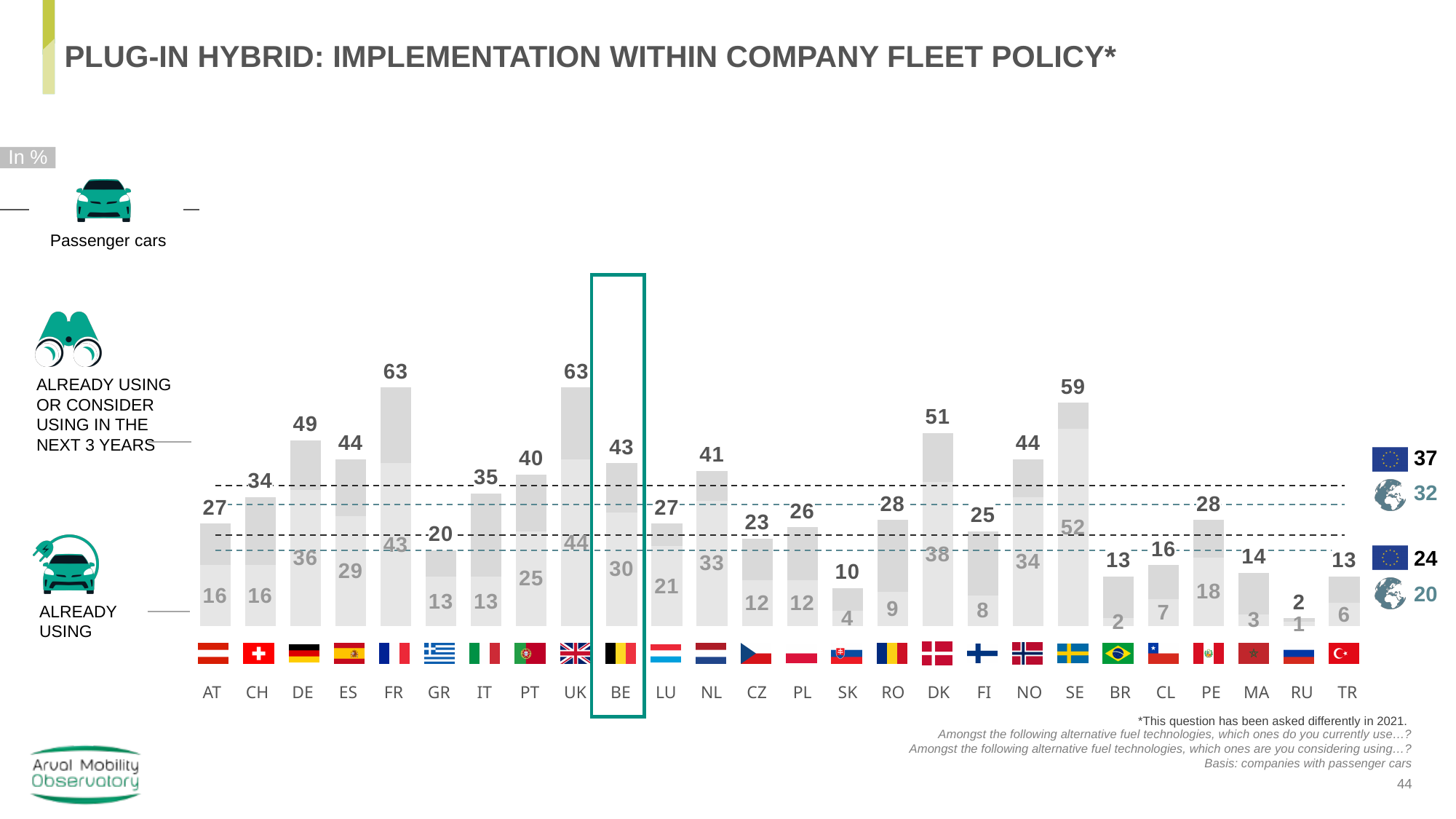
How many countries are shown on the x axis of the chart? 26 What is the 'already using or consider using in the next 3 years' value for Belgium (BE)? 43 Which two countries share the highest 'already using or consider using in the next 3 years' value of 63? FR and UK What kind of chart is used on this slide? Bar chart What is the 'already using' value for Sweden (SE)? 52 What is the global average for 'already using'? 20 What is the difference between the 'already using or consider using in the next 3 years' values for Germany (DE) and Austria (AT)? 22 What is the 'already using' value for Slovakia (SK)? 4 Which country has the lowest 'already using or consider using in the next 3 years' value? RU What is the EU average for 'already using or consider using in the next 3 years'? 37 Which country has the highest 'already using' value? SE Which has a higher 'already using' value, Denmark (DK) or Norway (NO)? DK